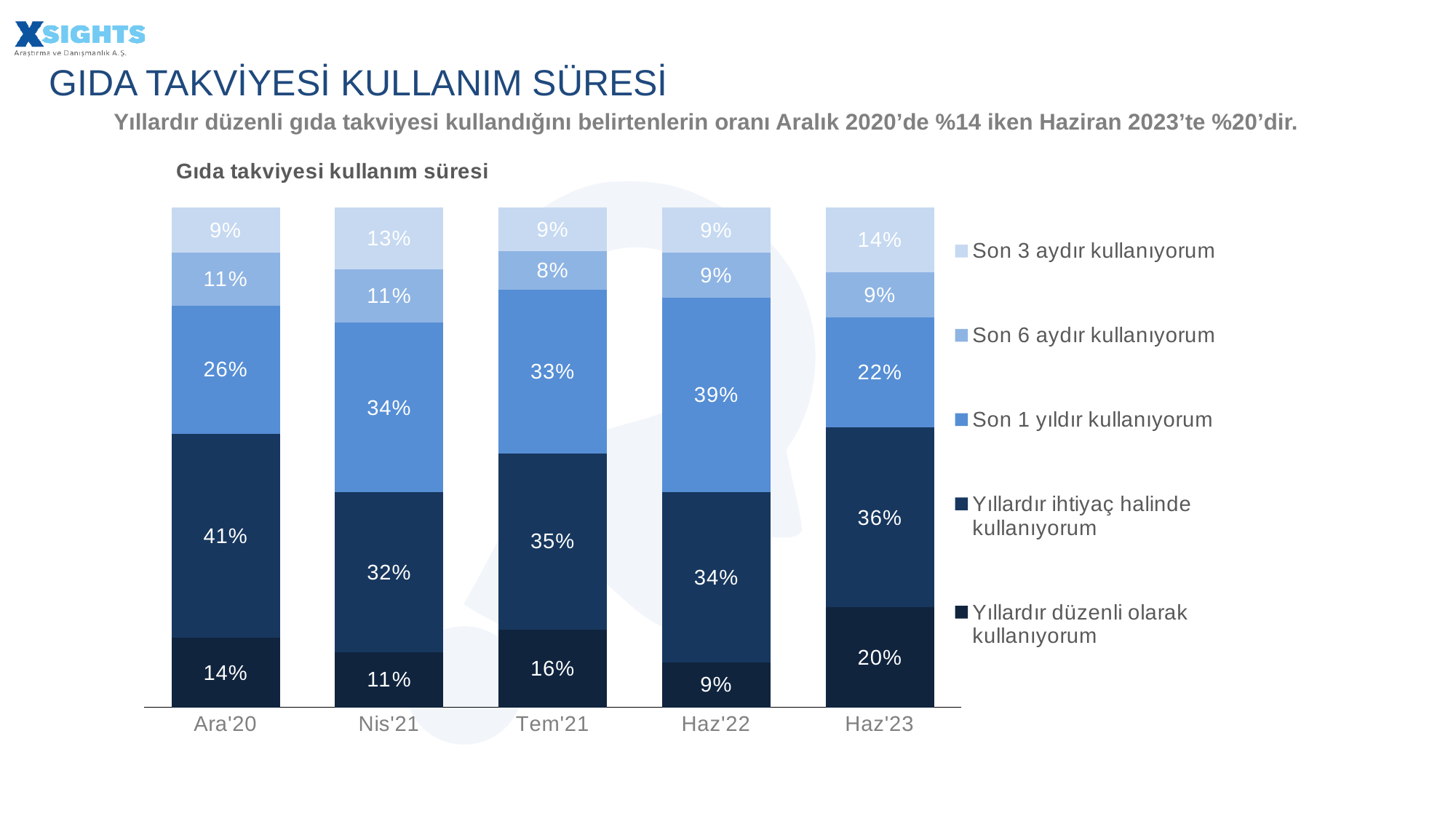
What is the difference between the "Son 1 yıldır kullanıyorum" values for Haz'22 and Haz'23? 17 percentage points Which segment is the largest in the Ara'20 bar? Yıllardır ihtiyaç halinde kullanıyorum In which period is the value for "Yıllardır düzenli olarak kullanıyorum" highest? Haz'23 How many periods are shown on the x axis? 5 In which period is the value for "Yıllardır düzenli olarak kullanıyorum" lowest? Haz'22 What is the value for "Son 6 aydır kullanıyorum" in Tem'21? 8% What is the value for "Son 1 yıldır kullanıyorum" in Haz'22? 39% What is the value for "Yıllardır düzenli olarak kullanıyorum" in Haz'23? 20% How many series does the legend list? 5 What is the value for "Son 3 aydır kullanıyorum" in Nis'21? 13% What kind of chart is shown on the slide? Stacked bar chart Which is larger: the "Yıllardır ihtiyaç halinde kullanıyorum" value for Ara'20 or for Tem'21? Ara'20